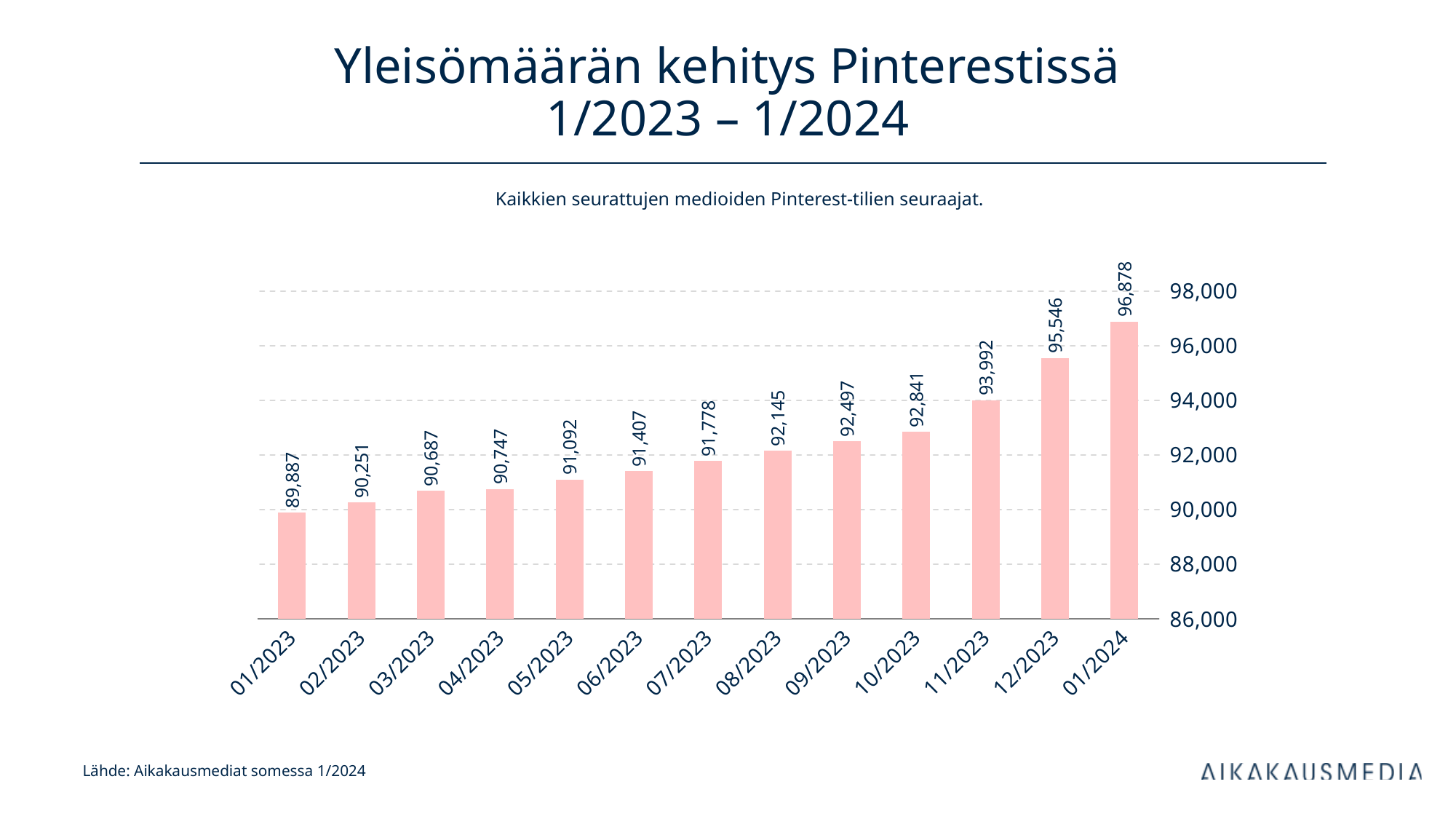
What is the value for 07/2023? 91,778 What is the difference between the values for 01/2024 and 01/2023? 6,991 What kind of chart is shown on the slide? bar chart What is the difference between the values for 12/2023 and 11/2023? 1,554 What is the value for 01/2023? 89,887 Do the values rise or fall from 01/2023 to 01/2024? rise Which month has the lowest value? 01/2023 How many months are shown on the x axis? 13 Which is larger, the value for 09/2023 or the value for 06/2023? 09/2023 Which month has the highest value? 01/2024 What is the value for 12/2023? 95,546 Is the value for 12/2023 greater or less than 96,000? less